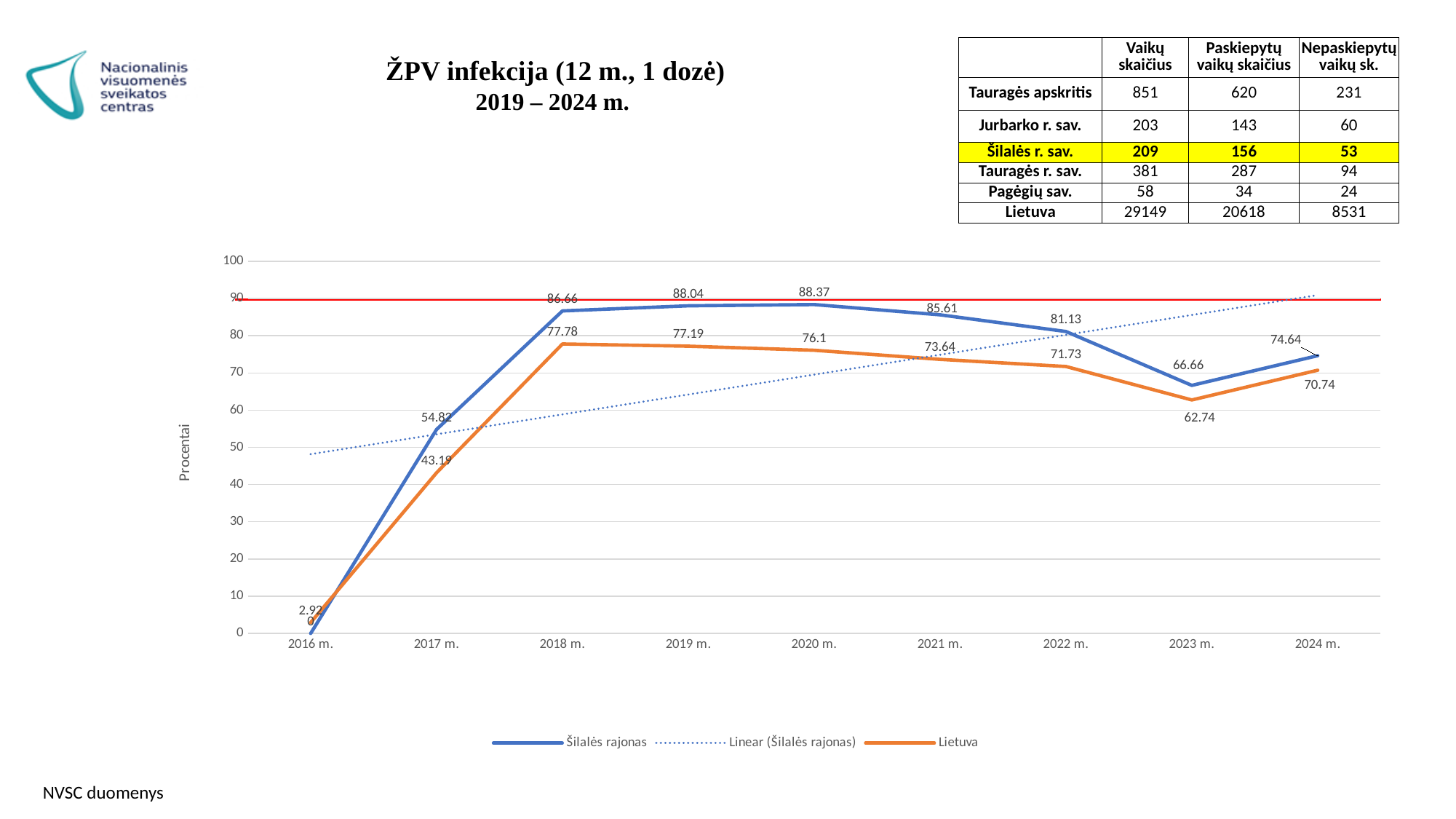
In which year does the Lietuva series have its lowest value? 2016 m. How many entries does the legend list? 3 In which year does the Šilalės rajonas series reach its highest value? 2020 m. What type of chart is shown on the slide? line chart Does the Šilalės rajonas series rise or fall from 2022 m. to 2023 m.? fall What is the value for Lietuva in 2017 m.? 43.19 What is the value for Lietuva in 2023 m.? 62.74 How many years are shown on the x axis? 9 What is the value for Šilalės rajonas in 2020 m.? 88.37 What is the label of the y axis? Procentai Which series has the larger value in 2022 m., Šilalės rajonas or Lietuva? Šilalės rajonas What is the difference between the Šilalės rajonas and Lietuva values in 2024 m.? 3.9